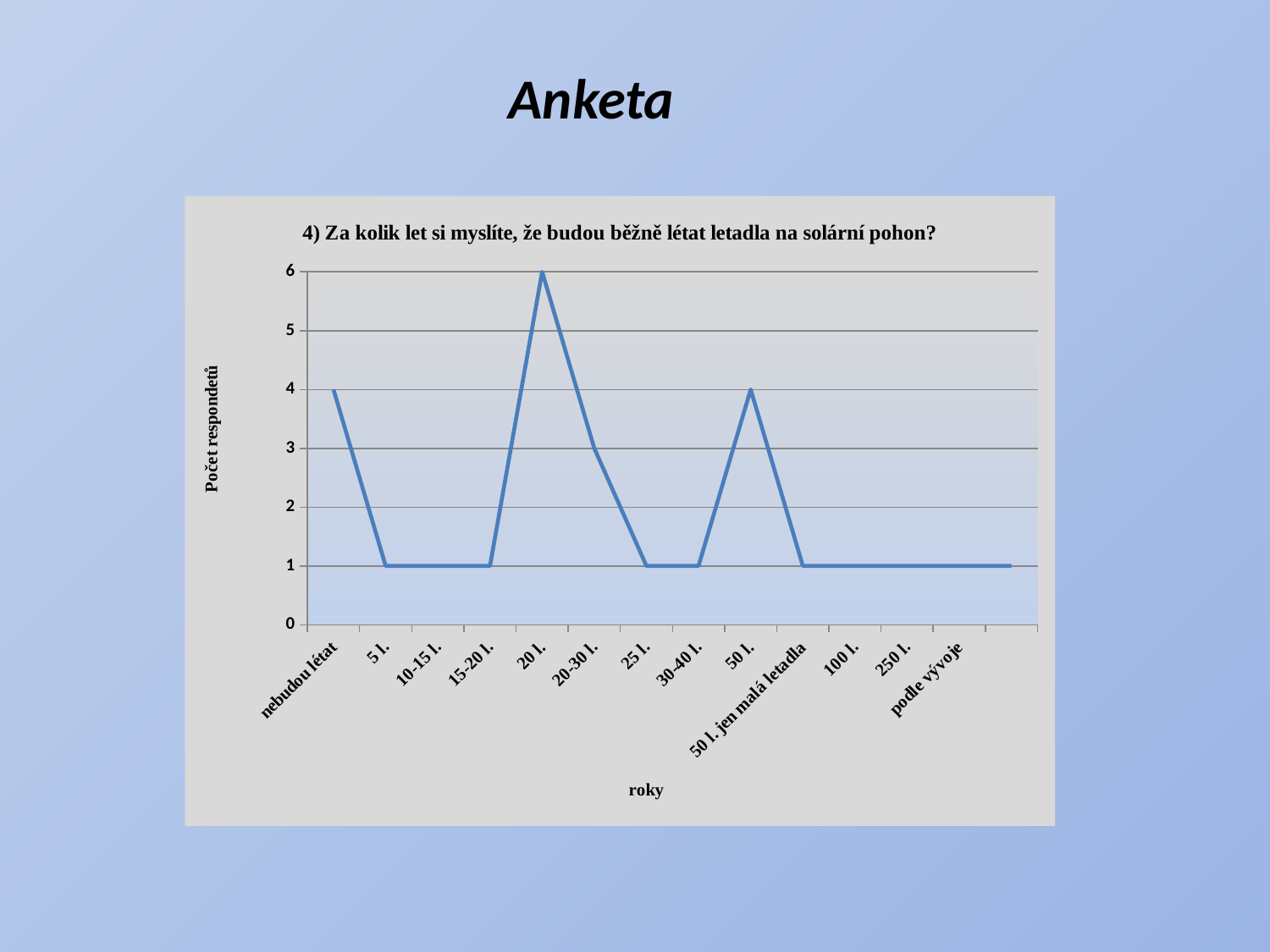
What is the difference between the values for '20 l.' and '50 l.'? 2 What is the title of the chart? 4) Za kolik let si myslíte, že budou běžně létat letadla na solární pohon? What is the label of the y axis? Počet respondetů How many categories are shown on the x axis of the chart? 13 What type of chart is shown on the slide? line chart Which category has the highest number of respondents? 20 l. What is the value for the category '50 l.'? 4 What is the value for the category '20-30 l.'? 3 Which is larger, the value for 'nebudou létat' or the value for '5 l.'? nebudou létat What is the value for the category '20 l.'? 6 What is the value for the category 'nebudou létat'? 4 What is the value for the category '100 l.'? 1